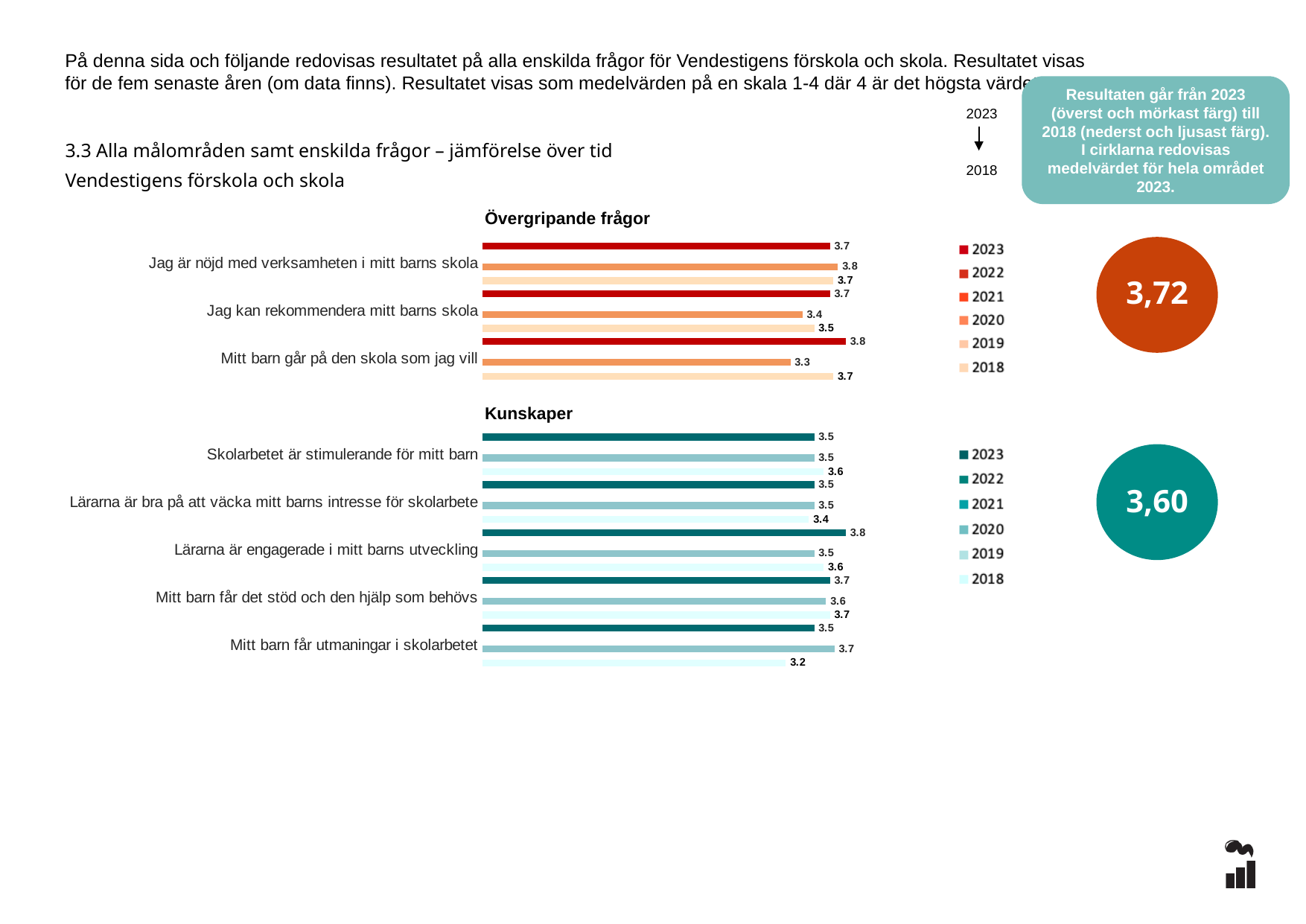
In the 'Övergripande frågor' chart, what is the value of the middle bar for 'Mitt barn går på den skola som jag vill'? 3.3 In the 'Kunskaper' chart, which question has the highest 2023 (top, darkest bar) value? Lärarna är engagerade i mitt barns utveckling In the 'Kunskaper' chart, what is the difference between the top bar (3.5) and the middle bar (3.7) for 'Mitt barn får utmaningar i skolarbetet'? 0.2 What type of chart is used for 'Övergripande frågor'? bar chart In the 'Övergripande frågor' chart, what is the 2023 (top, darkest bar) value for 'Mitt barn går på den skola som jag vill'? 3.8 In the 'Kunskaper' chart, what is the 2023 (top, darkest bar) value for 'Lärarna är engagerade i mitt barns utveckling'? 3.8 How many questions (categories) are shown in the 'Övergripande frågor' chart? 3 In the 'Kunskaper' chart, what is the value of the lightest (bottom) bar for 'Mitt barn får utmaningar i skolarbetet'? 3.2 In the 'Övergripande frågor' chart, which is larger for 'Jag kan rekommendera mitt barns skola': the top bar or the middle bar? the top bar How many years does the legend of the 'Kunskaper' chart list? 6 In the 'Övergripande frågor' chart, what is the 2023 (top, darkest bar) value for 'Jag kan rekommendera mitt barns skola'? 3.7 How many questions (categories) are shown in the 'Kunskaper' chart? 5